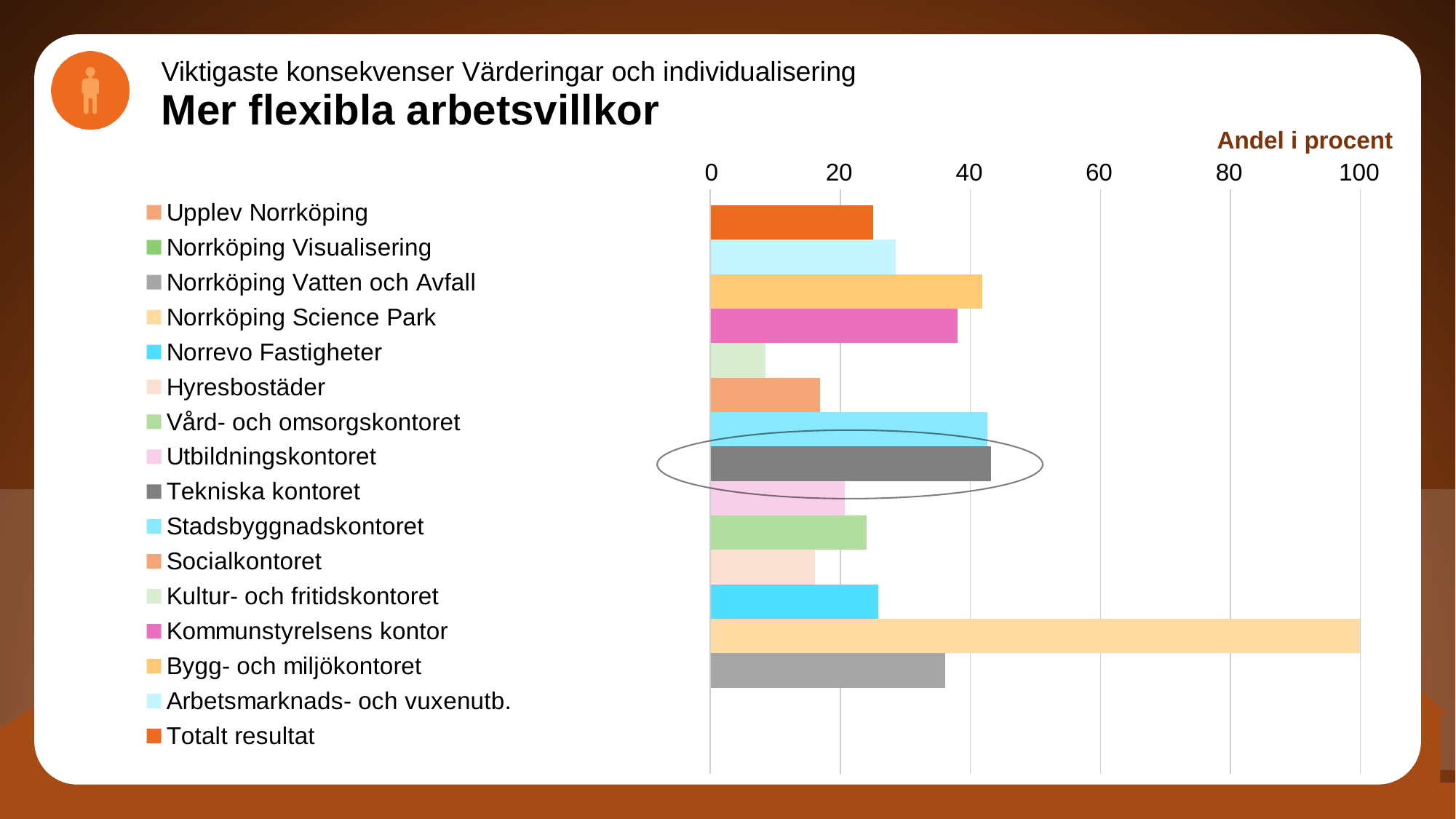
Is the value for Kommunstyrelsens kontor greater or less than 40? less Which category has the highest value in the chart? Norrköping Science Park Which is larger, the value for Norrevo Fastigheter or the value for Hyresbostäder? Norrevo Fastigheter How many entries does the legend list? 16 Is the value for Norrköping Vatten och Avfall greater or less than 40? less What is the label shown above the horizontal axis of the chart? Andel i procent Is the value for Kultur- och fritidskontoret greater or less than 20? less What kind of chart is shown on the slide? bar chart Which is larger, the value for Bygg- och miljökontoret or the value for Kommunstyrelsens kontor? Bygg- och miljökontoret What is the value for Norrköping Science Park? 100